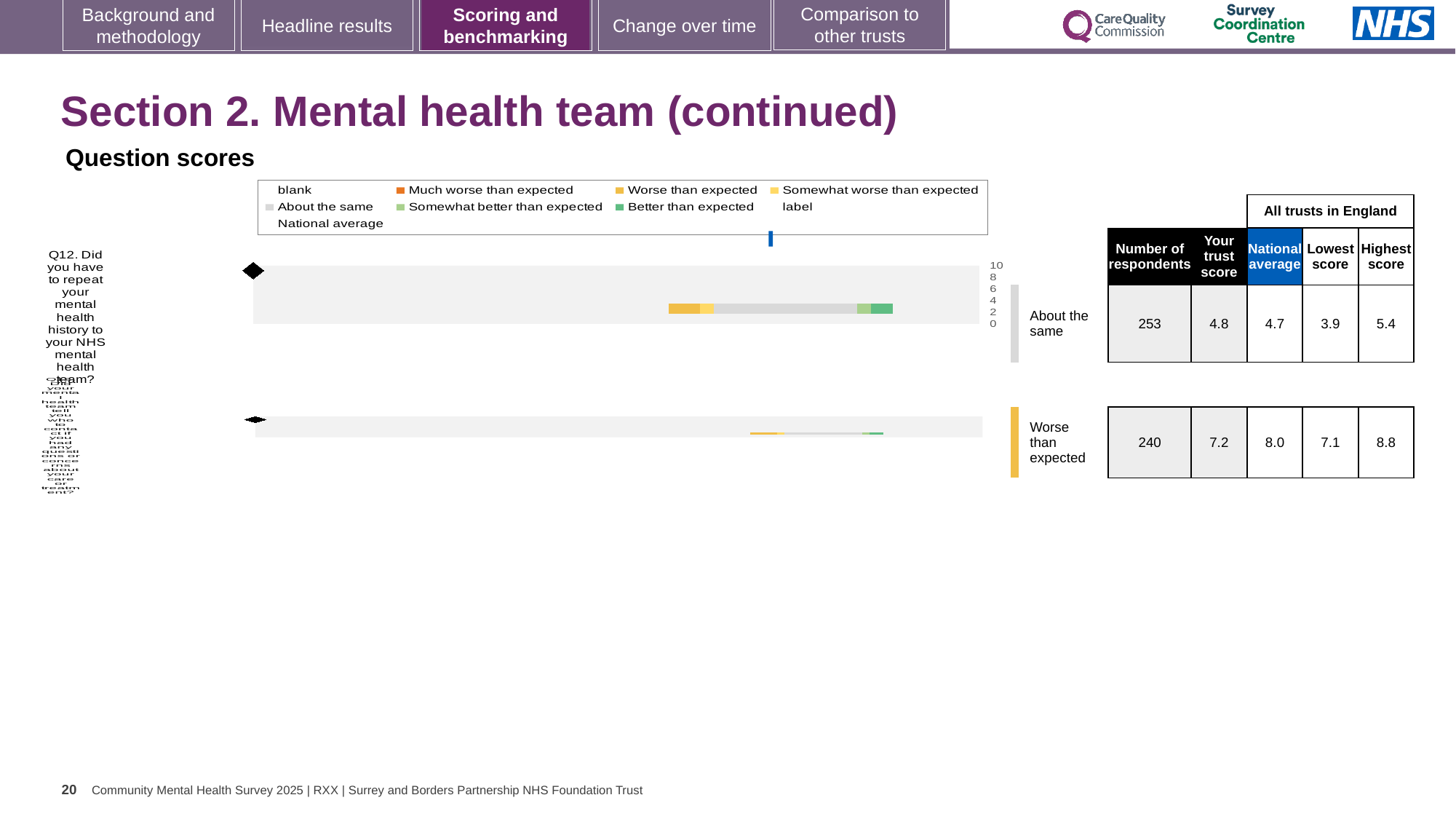
What is the national average for Q12 in the table beside the chart? 4.7 In the chart legend, what colour represents 'About the same'? grey What is the highest score among all trusts in England for the second (lower) question row? 8.8 What is the difference between the highest and lowest scores for Q12 in the table beside the chart? 1.5 Which question row has more respondents, Q12 or the second (lower) row? Q12 In the chart legend, what colour represents 'Better than expected'? green What is the benchmark category shown for the second (lower) question row? Worse than expected What kind of chart is used to show the question scores on this slide? bar chart How many respondents are listed for the second (lower) question row? 240 How many question rows are plotted in the question scores chart? 2 What is 'Your trust score' for Q12 in the table beside the chart? 4.8 What is the benchmark category shown for Q12 (repeating mental health history)? About the same